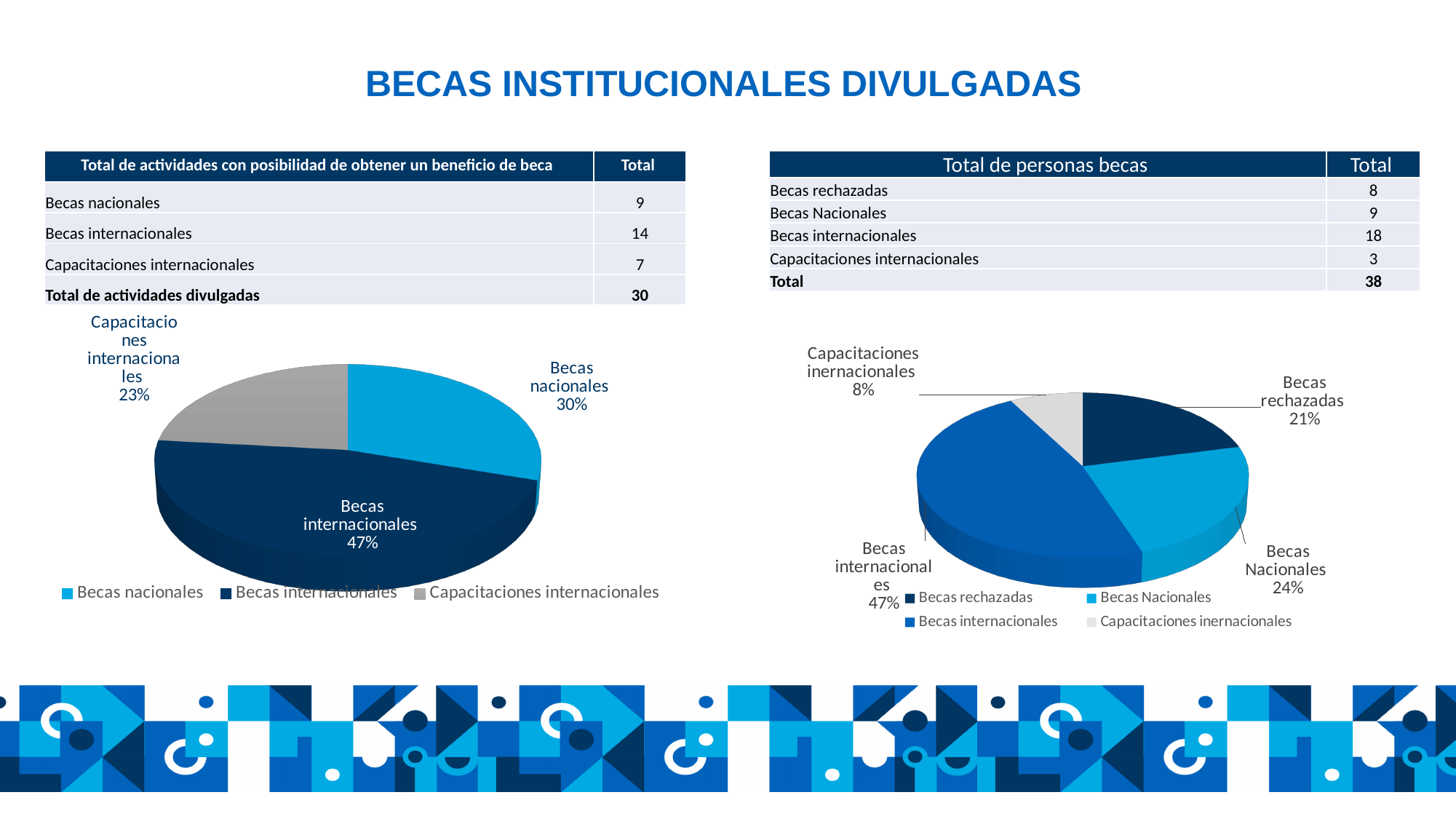
In the right pie chart, which is larger, Becas Nacionales or Becas rechazadas? Becas Nacionales In the left pie chart, what is the difference in percentage points between Becas internacionales and Becas nacionales? 17 In the left pie chart, what share is labelled for Capacitaciones internacionales? 23% In the right pie chart, which slice is the smallest? Capacitaciones inernacionales What type of chart is shown on the right side of the slide? Pie chart In the right pie chart, how many entries does the legend list? 4 In the left pie chart, which slice is the smallest? Capacitaciones internacionales In the right pie chart, what share is labelled for Becas Nacionales? 24% In the right pie chart, what share is labelled for Becas rechazadas? 21% In the left pie chart, how many slices are there? 3 In the left pie chart, which slice is the largest? Becas internacionales